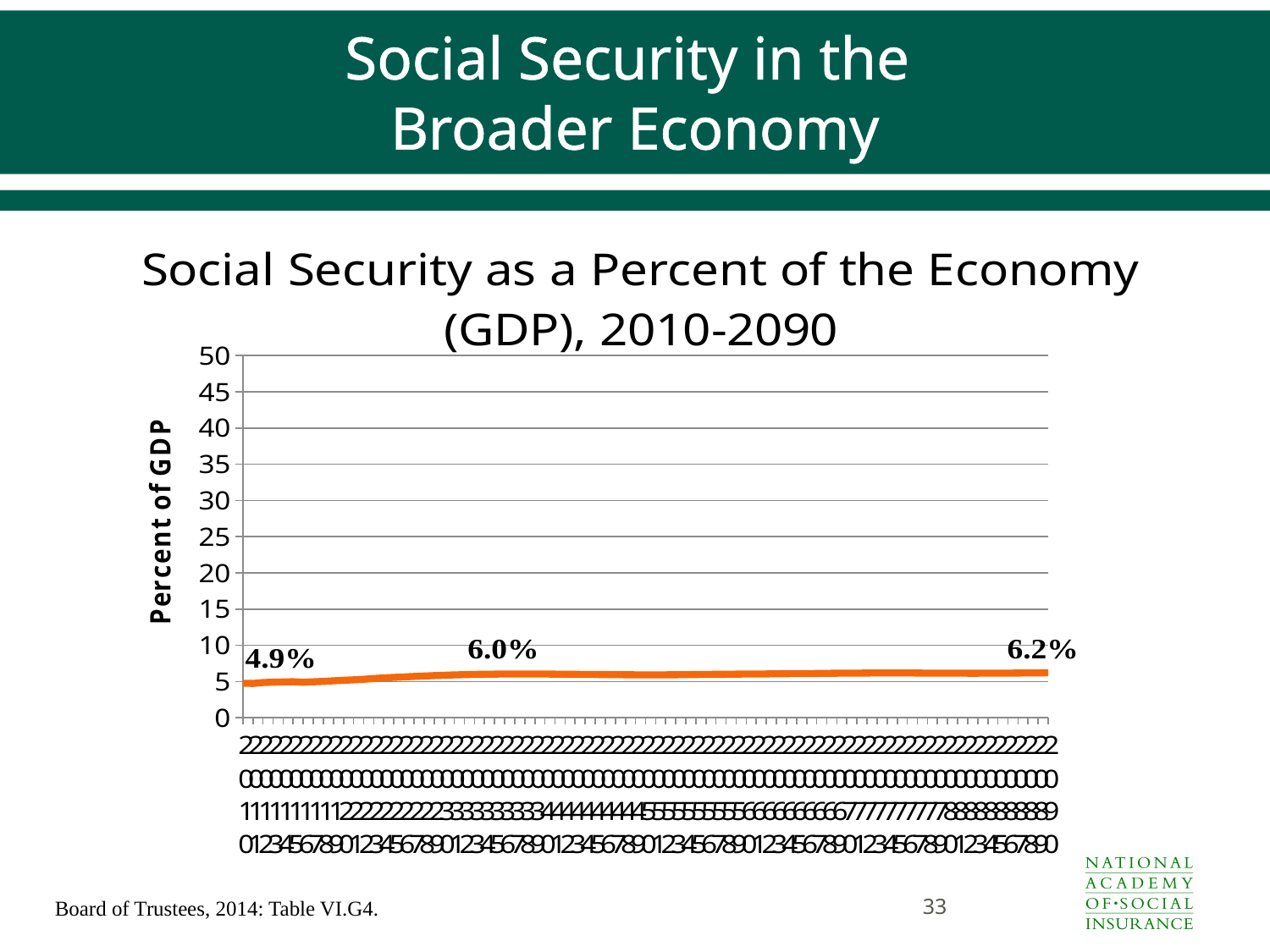
Is the value for 2050 greater or less than 10? less Which labeled value is the lowest on the chart? 4.9% What is the difference between the 2090 value and the 2010 value? 1.3 percentage points What value is labeled at the end of the line, in 2090? 6.2% What is the middle data label shown on the line, around the mid-2030s? 6.0% What kind of chart is shown on the slide? line chart Does the line generally rise or fall from 2010 to 2090? rise What is the label on the vertical axis of the chart? Percent of GDP What is the title of the chart on the slide? Social Security as a Percent of the Economy (GDP), 2010-2090 Is the value for 2090 larger or smaller than the value for 2010? larger What value is labeled at the start of the line, in 2010? 4.9% Which labeled value is the highest on the chart? 6.2%